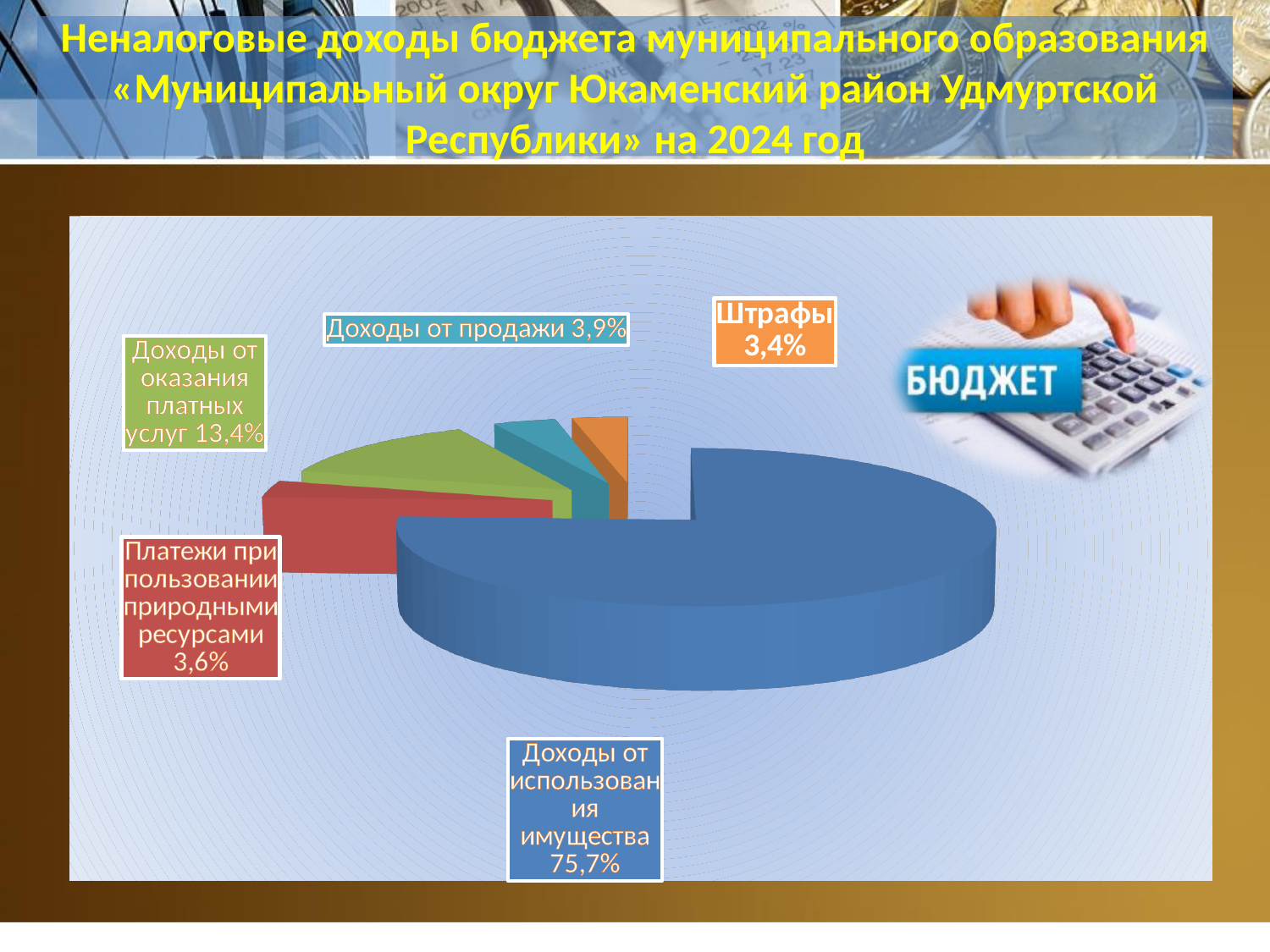
Which category has the smallest slice of the pie? Штрафы What share of the pie is labelled for Доходы от использования имущества? 75,7% What value is printed for Доходы от продажи? 3,9% What percentage is shown for Доходы от оказания платных услуг? 13,4% Which category has the largest slice of the pie? Доходы от использования имущества What is the difference in percentage points between Доходы от использования имущества and Доходы от оказания платных услуг? 62,3 What percentage is shown for Платежи при пользовании природными ресурсами? 3,6% What colour is the slice for Доходы от оказания платных услуг? Green What value is printed for Штрафы? 3,4% What kind of chart is shown on the slide? Pie chart Which is larger: Доходы от продажи or Штрафы? Доходы от продажи How many slices does the pie chart have? 5